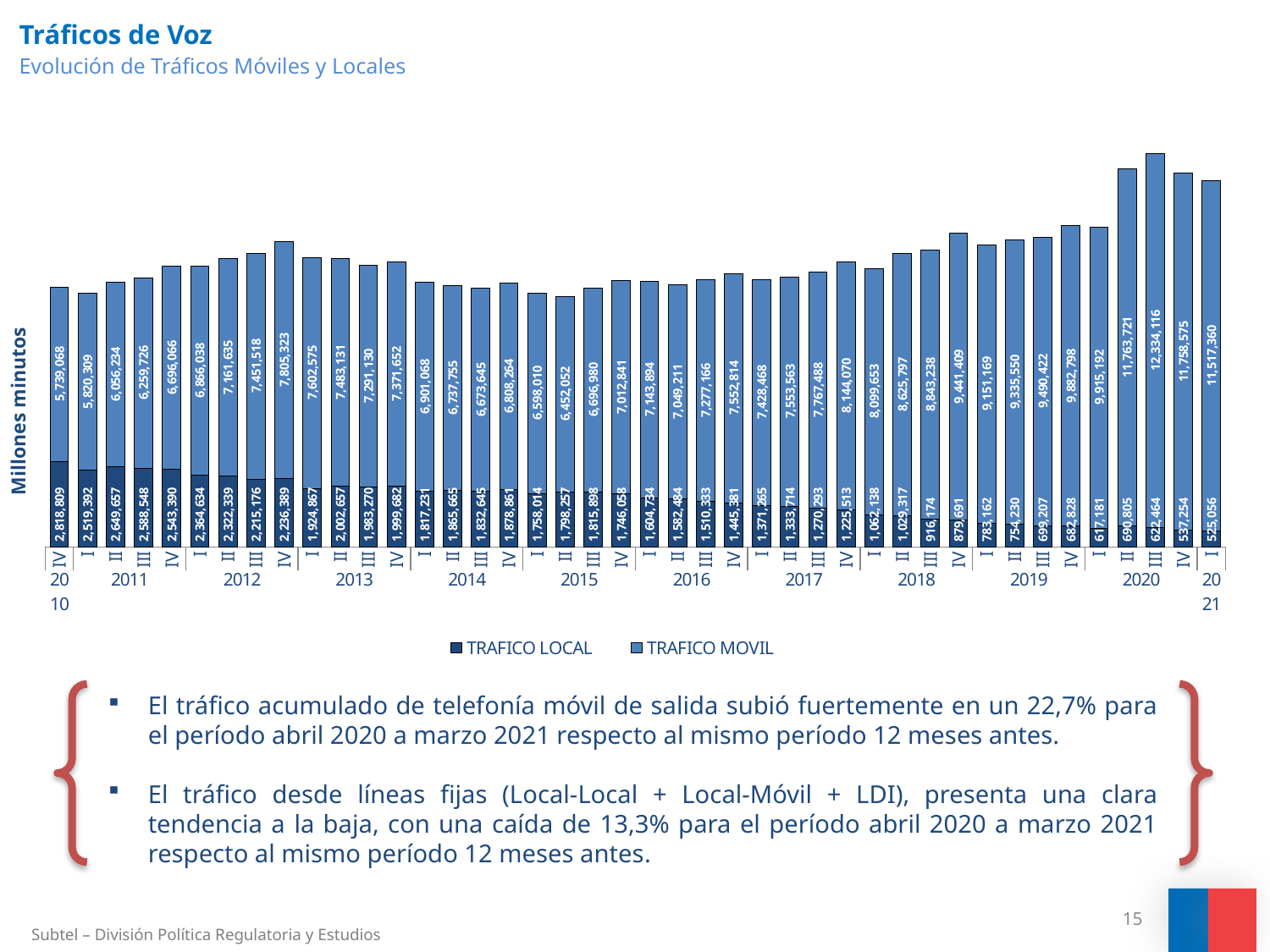
How many series does the legend list? 2 In which quarter is the TRAFICO MOVIL value highest? III 2020 What kind of chart is shown on the slide? Stacked bar chart Which is larger, the TRAFICO MOVIL value for quarter IV of 2012 or for quarter I of 2013? IV 2012 What is the TRAFICO MOVIL value for quarter III of 2020? 12,334,116 What is the label on the vertical axis of the chart? Millones minutos What is the difference between the TRAFICO MOVIL values for quarter III of 2020 and quarter II of 2020? 570,395 What is the TRAFICO LOCAL value for quarter I of 2021? 525,056 In which quarter is the TRAFICO LOCAL value lowest? I 2021 Does the TRAFICO LOCAL series generally rise or fall from 2010 to 2021? Fall What is the TRAFICO LOCAL value for quarter IV of 2010? 2,818,809 What is the total of the stacked bar for quarter I of 2021? 12,042,416